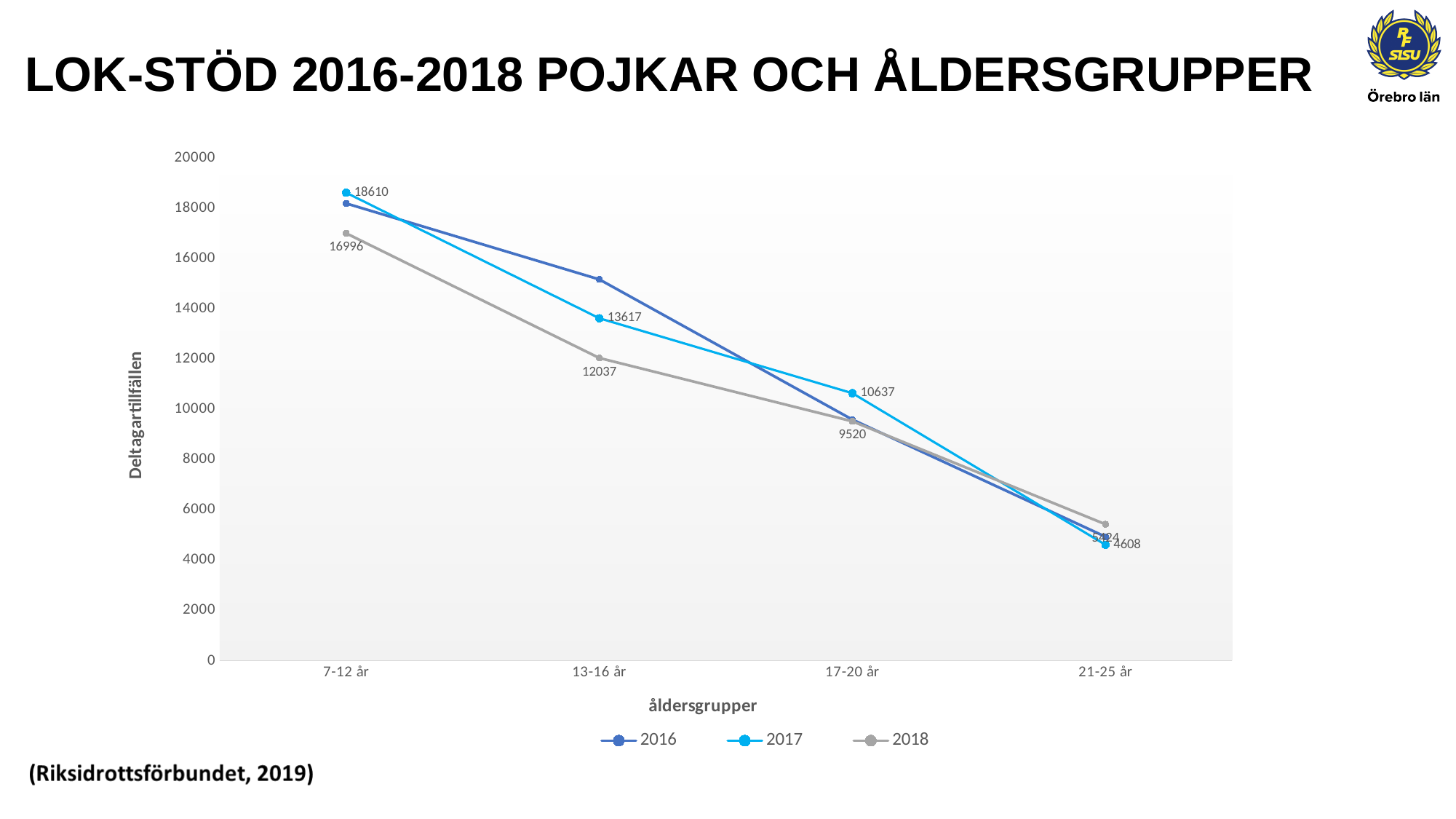
What is the difference between the 2017 values for 7-12 år and 13-16 år? 4993 How many age groups are shown on the x axis? 4 What is the value for 2017 in the 7-12 år age group? 18610 What is the value for 2017 in the 17-20 år age group? 10637 Is the 2016 value for 13-16 år greater or less than 14000? greater What kind of chart is shown on the slide? line chart Do the 2017 values rise or fall as the age groups increase along the x axis? fall What is the difference between the 2018 values for 7-12 år and 13-16 år? 4959 What is the value for 2018 in the 13-16 år age group? 12037 Which age group has the highest value for 2018? 7-12 år How many series does the legend list? 3 What is the value for 2017 in the 21-25 år age group? 4608